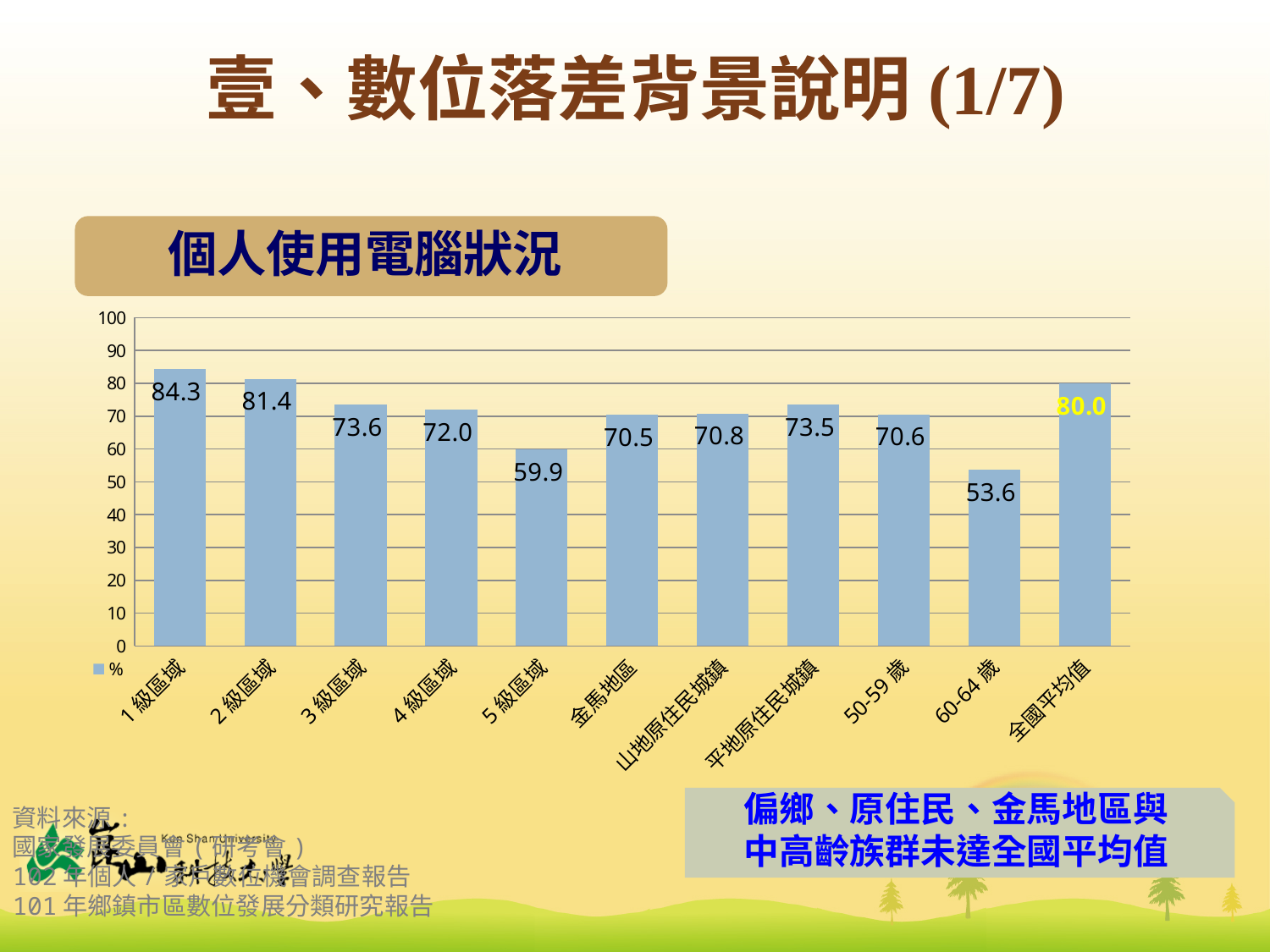
Which category has the highest value? 1級區域 What is the title shown above the chart? 個人使用電腦狀況 What is the value for 金馬地區? 70.5 Which category has the lowest value? 60-64歲 What kind of chart is shown? bar chart How many series does the legend list? 1 What is the value for 全國平均值? 80.0 What is the value for 60-64歲? 53.6 Which is larger, the value for 2級區域 or the value for 全國平均值? 2級區域 What is the difference between the values for 1級區域 and 5級區域? 24.4 What is the value for 1級區域? 84.3 How many categories are shown on the x axis? 11